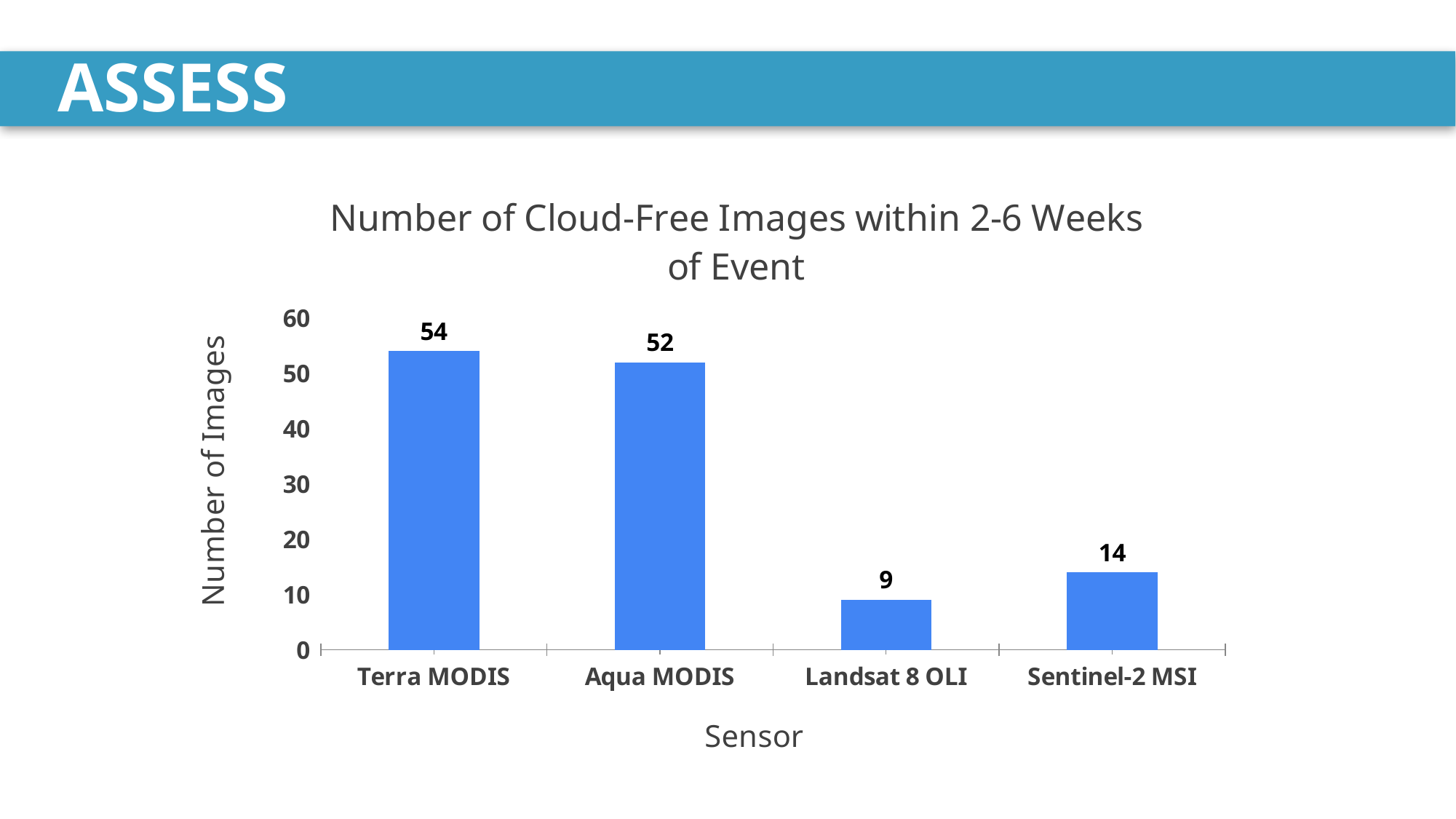
How many cloud-free images does Terra MODIS have? 54 What is the value for Landsat 8 OLI? 9 Which has more cloud-free images, Aqua MODIS or Sentinel-2 MSI? Aqua MODIS What is the difference between the values for Terra MODIS and Aqua MODIS? 2 Which sensor has the highest number of cloud-free images? Terra MODIS What is the difference between the values for Sentinel-2 MSI and Landsat 8 OLI? 5 Which sensor has the lowest number of cloud-free images? Landsat 8 OLI What kind of chart is shown on the slide? bar chart What is the title of the chart? Number of Cloud-Free Images within 2-6 Weeks of Event What is the number of images for Sentinel-2 MSI? 14 Is the value for Aqua MODIS greater or less than 40? greater How many sensors are shown on the x axis? 4